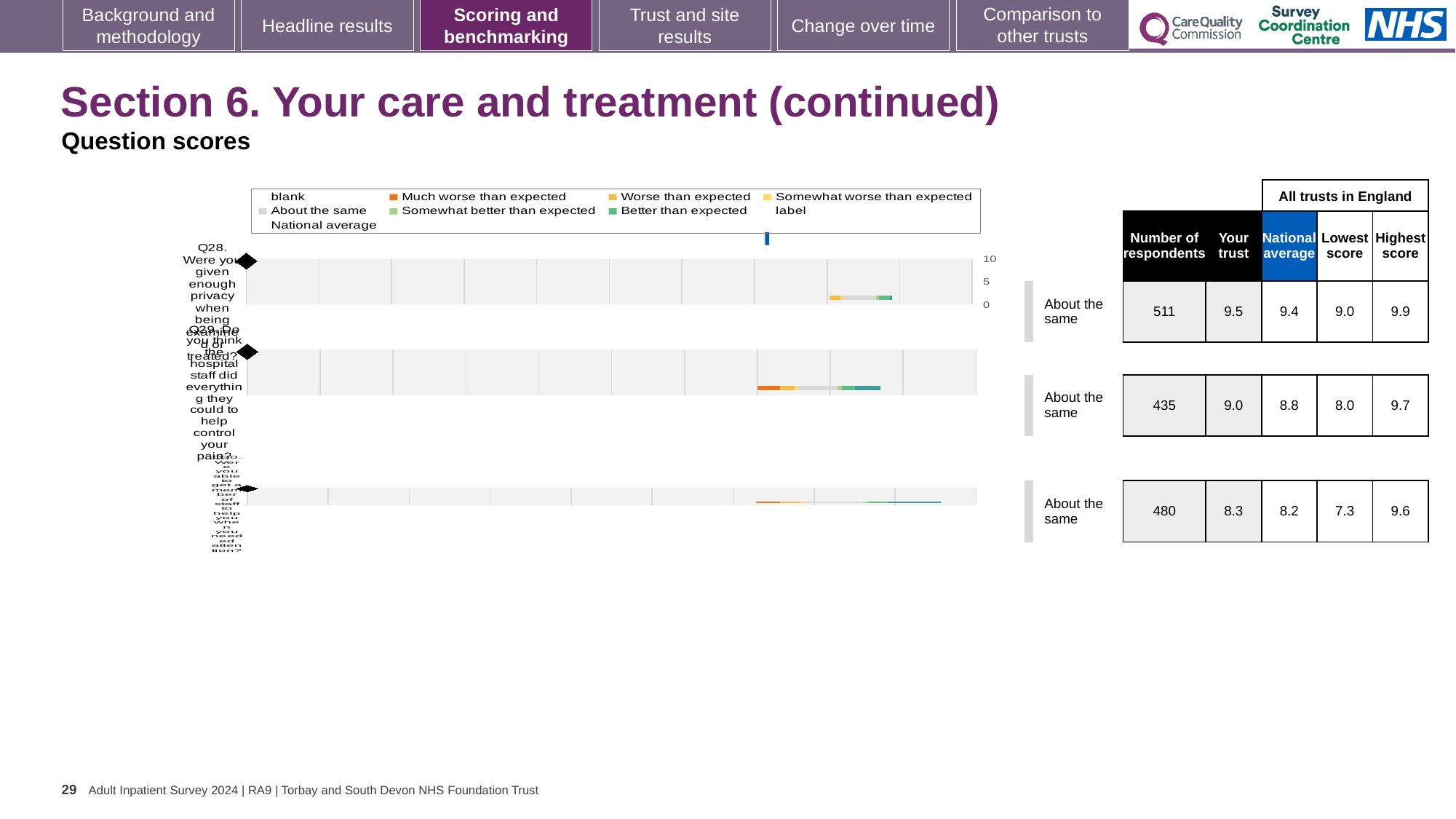
What colour does the legend use for 'Much worse than expected'? orange What is the difference between the trust's score and the national average for Q29? 0.2 What is the highest value shown on the chart's axis? 10 What kind of chart is shown on the slide? bar chart What is the national average score for Q29 (hospital staff helping control pain)? 8.8 How many questions (categories) are plotted on the chart? 3 Which question has the lowest trust score? Q30 Which question has the highest trust score? Q28 What is the trust's score for Q30 (able to get a member of staff to help when needed)? 8.3 How many respondents answered Q30? 480 Is the trust's score for Q28 larger or smaller than the national average for Q28? larger What is the trust's score for Q28 (privacy when being examined or treated)? 9.5